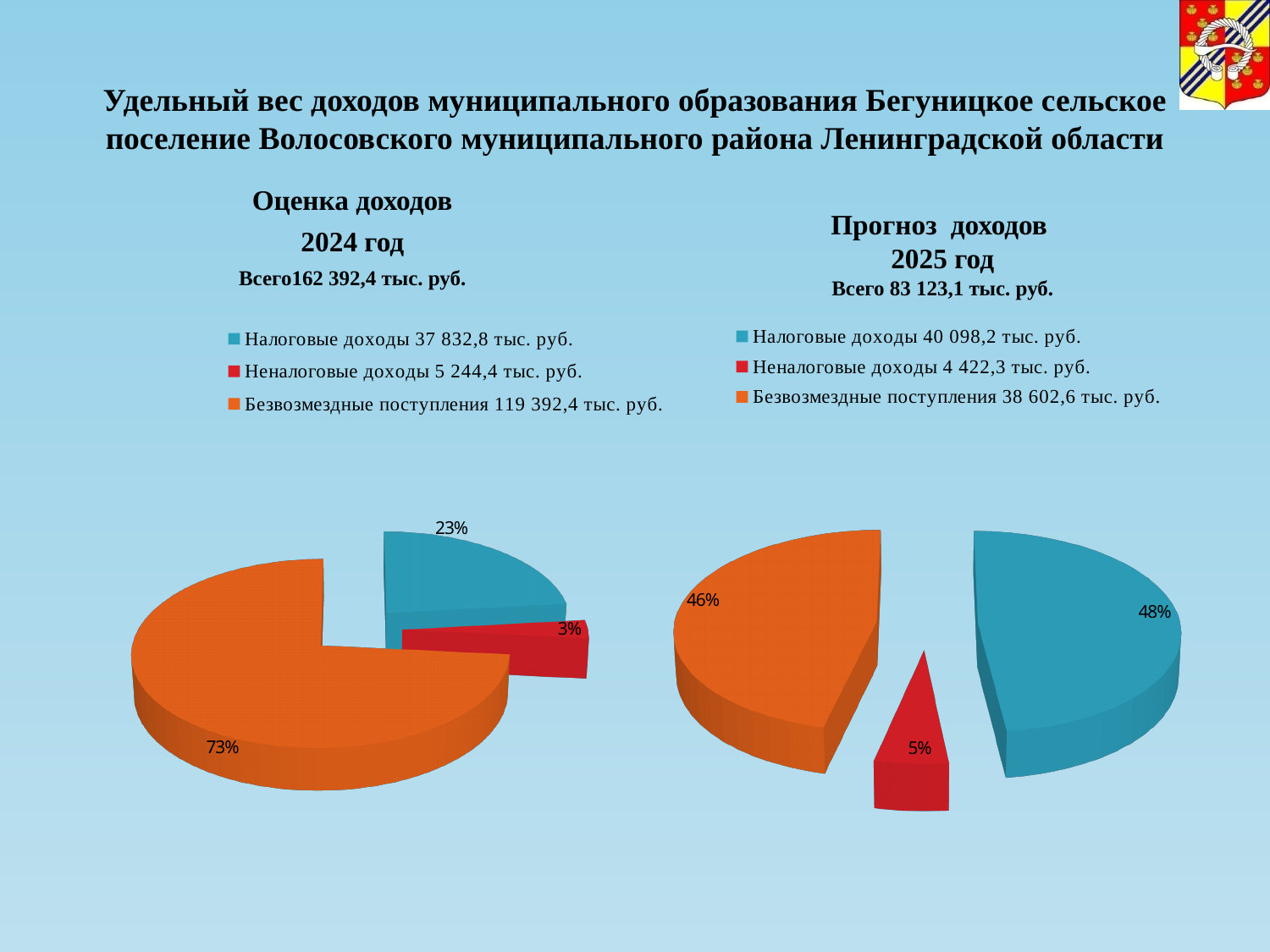
In the right pie chart (Прогноз доходов 2025 год), which category has the smallest share? Неналоговые доходы How many entries does the legend of the left chart (Оценка доходов 2024 год) list? 3 In the right pie chart (Прогноз доходов 2025 год), which has the larger share: Налоговые доходы or Безвозмездные поступления? Налоговые доходы According to the legend of the left chart (Оценка доходов 2024 год), what is the value of Налоговые доходы? 37 832,8 тыс. руб. How many slices does the right pie chart (Прогноз доходов 2025 год) have? 3 According to the legend of the right chart (Прогноз доходов 2025 год), what is the value of Безвозмездные поступления? 38 602,6 тыс. руб. In the left pie chart (Оценка доходов 2024 год), which category has the largest share? Безвозмездные поступления What kind of chart is the left chart (Оценка доходов 2024 год)? pie chart In the left pie chart (Оценка доходов 2024 год), what is the difference in percentage points between the shares of Безвозмездные поступления and Налоговые доходы? 50 percentage points In the right pie chart (Прогноз доходов 2025 год), what share is shown for Неналоговые доходы? 5% In the right pie chart (Прогноз доходов 2025 год), what share is shown for Налоговые доходы? 48% In the left pie chart (Оценка доходов 2024 год), what share is shown for Безвозмездные поступления? 73%